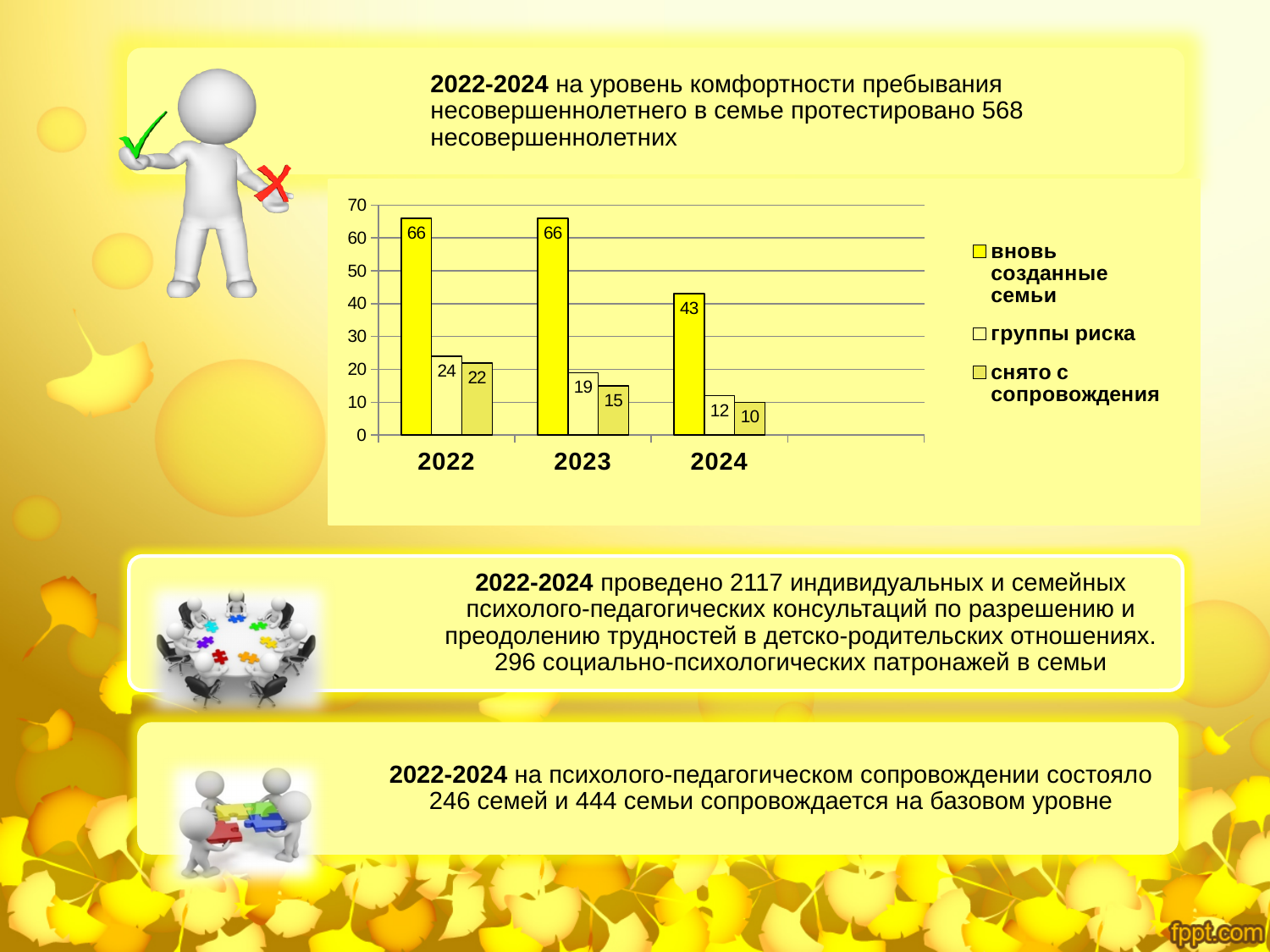
What is the difference between the "вновь созданные семьи" values for 2023 and 2024? 23 Does the value for "снято с сопровождения" rise or fall from 2022 to 2024? fall How many years (categories) are shown on the x axis? 3 What is the value for "вновь созданные семьи" in 2024? 43 In which year is the value for "снято с сопровождения" highest? 2022 What kind of chart is shown on the slide? bar chart In which year is the value for "группы риска" lowest? 2024 What is the difference between "группы риска" and "снято с сопровождения" in 2022? 2 Which is larger in 2023: "группы риска" or "снято с сопровождения"? группы риска How many series does the legend list? 3 What is the value for "группы риска" in 2022? 24 What is the value for "снято с сопровождения" in 2023? 15